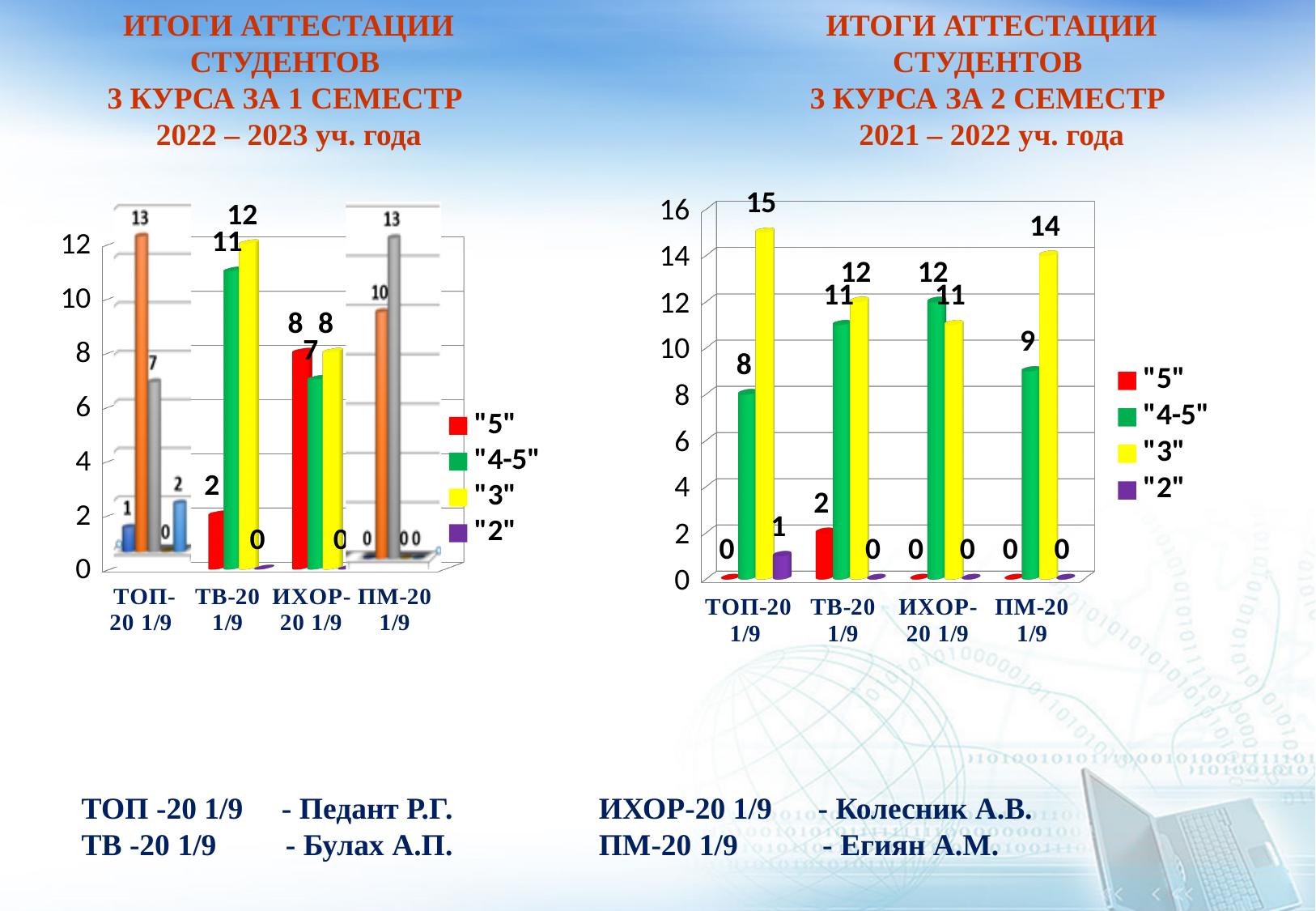
How many series does the legend of the right chart (3 курса за 2 семестр 2021 – 2022) list? 4 In the right chart (3 курса за 2 семестр 2021 – 2022), which is larger for ИХОР-20 1/9: the "4-5" value or the "3" value? "4-5" In the left chart (3 курса за 1 семестр 2022 – 2023), what is the value of "5" for ИХОР-20 1/9? 8 What kind of chart is the right chart (3 курса за 2 семестр 2021 – 2022)? Bar chart In the right chart (3 курса за 2 семестр 2021 – 2022), which group has the highest value for "3"? ТОП-20 1/9 In the right chart (3 курса за 2 семестр 2021 – 2022), what is the value of "4-5" for ПМ-20 1/9? 9 In the right chart (3 курса за 2 семестр 2021 – 2022), what is the value of "5" for ТВ-20 1/9? 2 In the right chart (3 курса за 2 семестр 2021 – 2022), what is the value of "3" for ТОП-20 1/9? 15 How many groups are shown on the x axis of the right chart (3 курса за 2 семестр 2021 – 2022)? 4 In the right chart (3 курса за 2 семестр 2021 – 2022), which group has the lowest value for "4-5"? ТОП-20 1/9 In the right chart (3 курса за 2 семестр 2021 – 2022), what is the difference between the "3" value for ТОП-20 1/9 and the "3" value for ИХОР-20 1/9? 4 In the left chart (3 курса за 1 семестр 2022 – 2023), what is the value of "4-5" for ТВ-20 1/9? 11